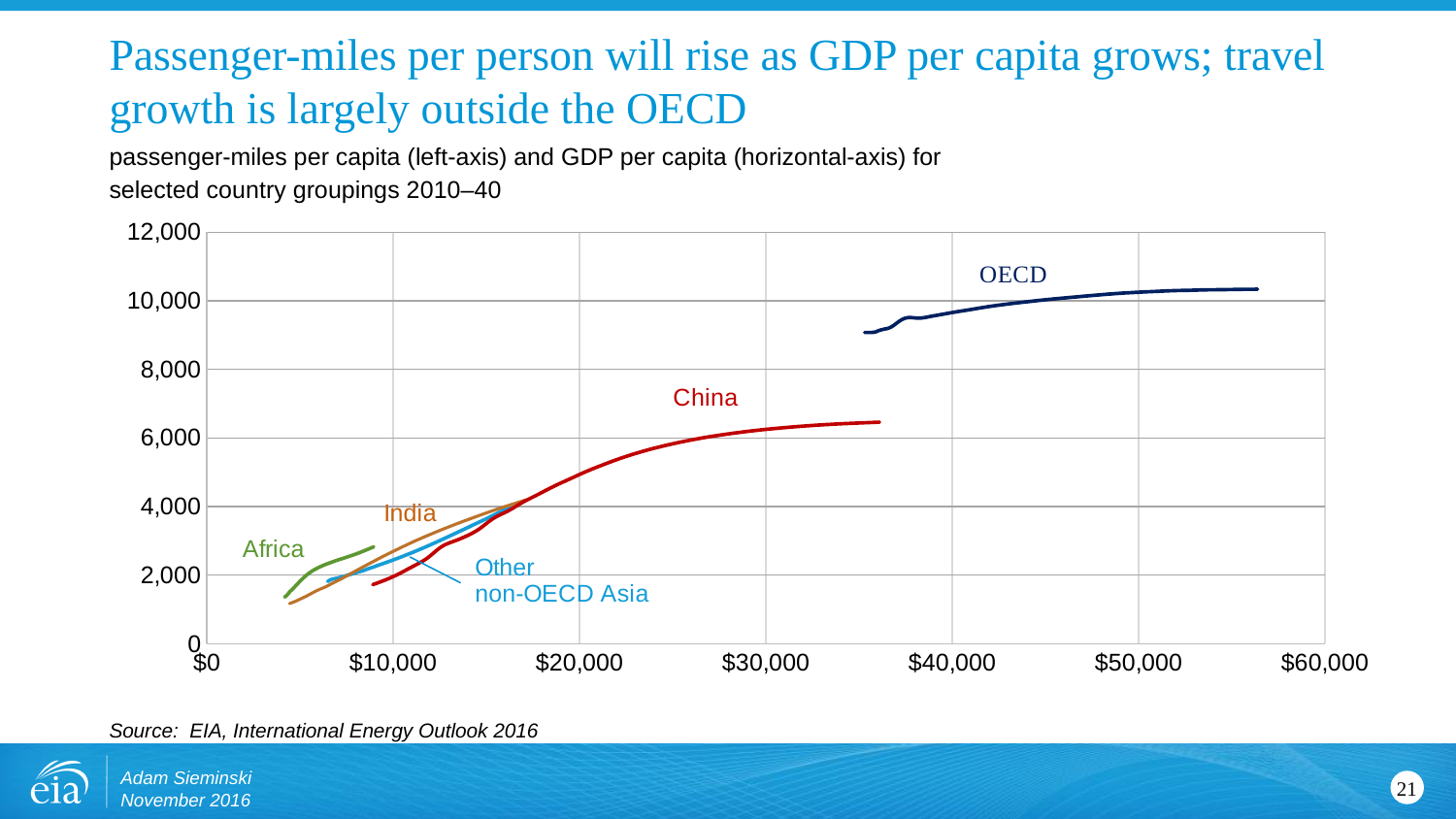
What is the source cited for the chart? EIA, International Energy Outlook 2016 How many country groupings are plotted as lines on the chart? 5 Is the passenger-miles per capita value for Africa greater or less than 4,000? less What kind of chart is shown on the slide? line chart What period do the plotted lines cover, according to the chart subtitle? 2010–40 Which country grouping has the highest passenger-miles per capita on the chart? OECD Is the highest GDP per capita reached by the China line greater or less than $40,000? less Which country grouping reaches the highest GDP per capita on the horizontal axis? OECD Do passenger-miles per capita rise or fall as GDP per capita increases along the horizontal axis? rise Is the highest passenger-miles per capita value reached by China greater or less than 8,000? less Which has higher passenger-miles per capita, OECD or China? OECD